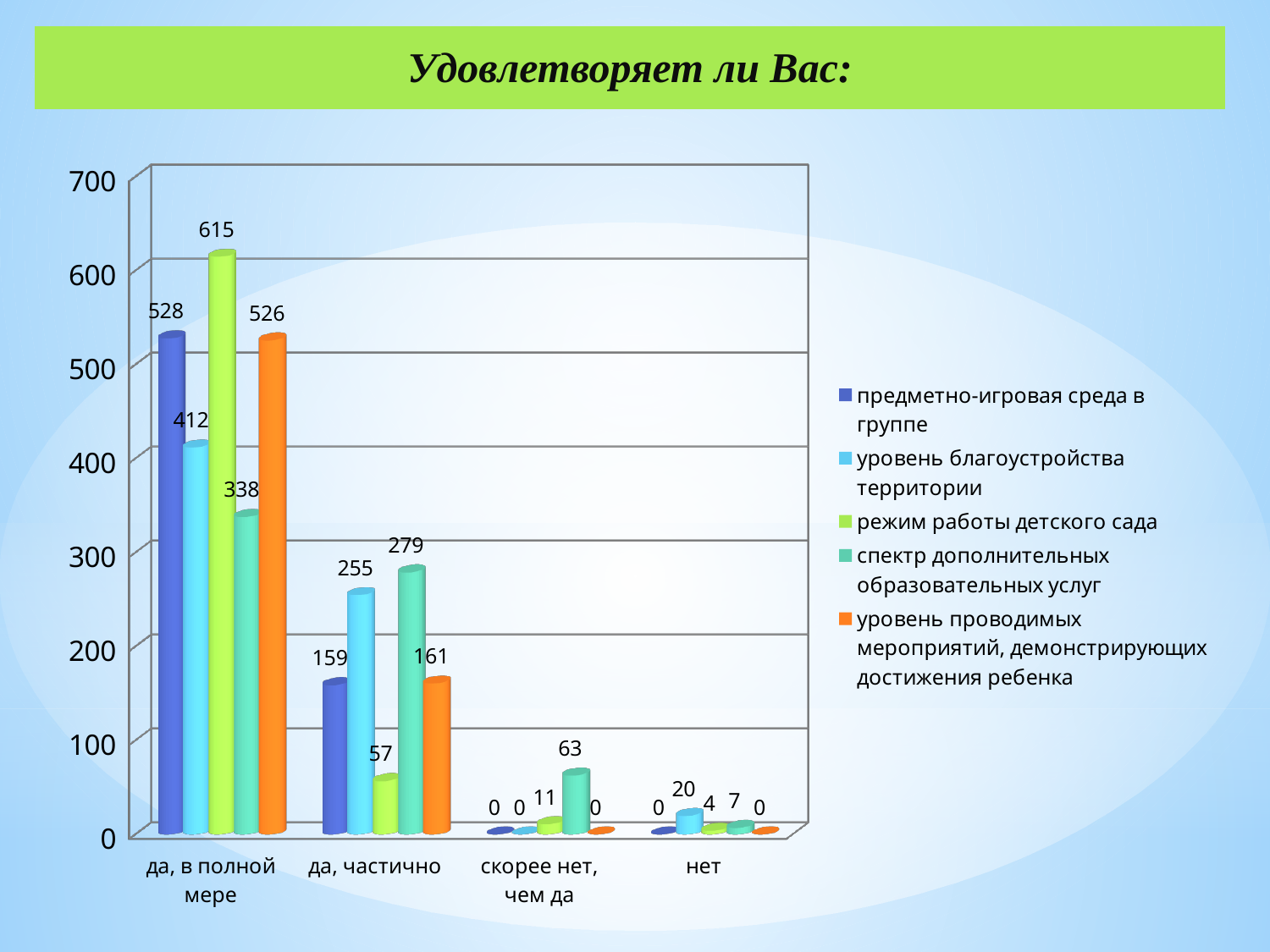
What is the difference between the values for 'предметно-игровая среда в группе' and 'спектр дополнительных образовательных услуг' in the category 'да, в полной мере'? 190 What kind of chart is shown on the slide? bar chart In the category 'да, частично', which is larger: 'предметно-игровая среда в группе' or 'уровень проводимых мероприятий, демонстрирующих достижения ребенка'? уровень проводимых мероприятий, демонстрирующих достижения ребенка What is the value for 'спектр дополнительных образовательных услуг' in the category 'скорее нет, чем да'? 63 What is the value for 'режим работы детского сада' in the category 'да, в полной мере'? 615 What is the value for 'уровень благоустройства территории' in the category 'нет'? 20 How many series does the legend list? 5 What is the value for 'уровень благоустройства территории' in the category 'да, частично'? 255 What is the title of the slide? Удовлетворяет ли Вас: Which series has the lowest value in the category 'да, частично'? режим работы детского сада How many categories are shown on the x axis? 4 Which series has the highest value in the category 'да, в полной мере'? режим работы детского сада